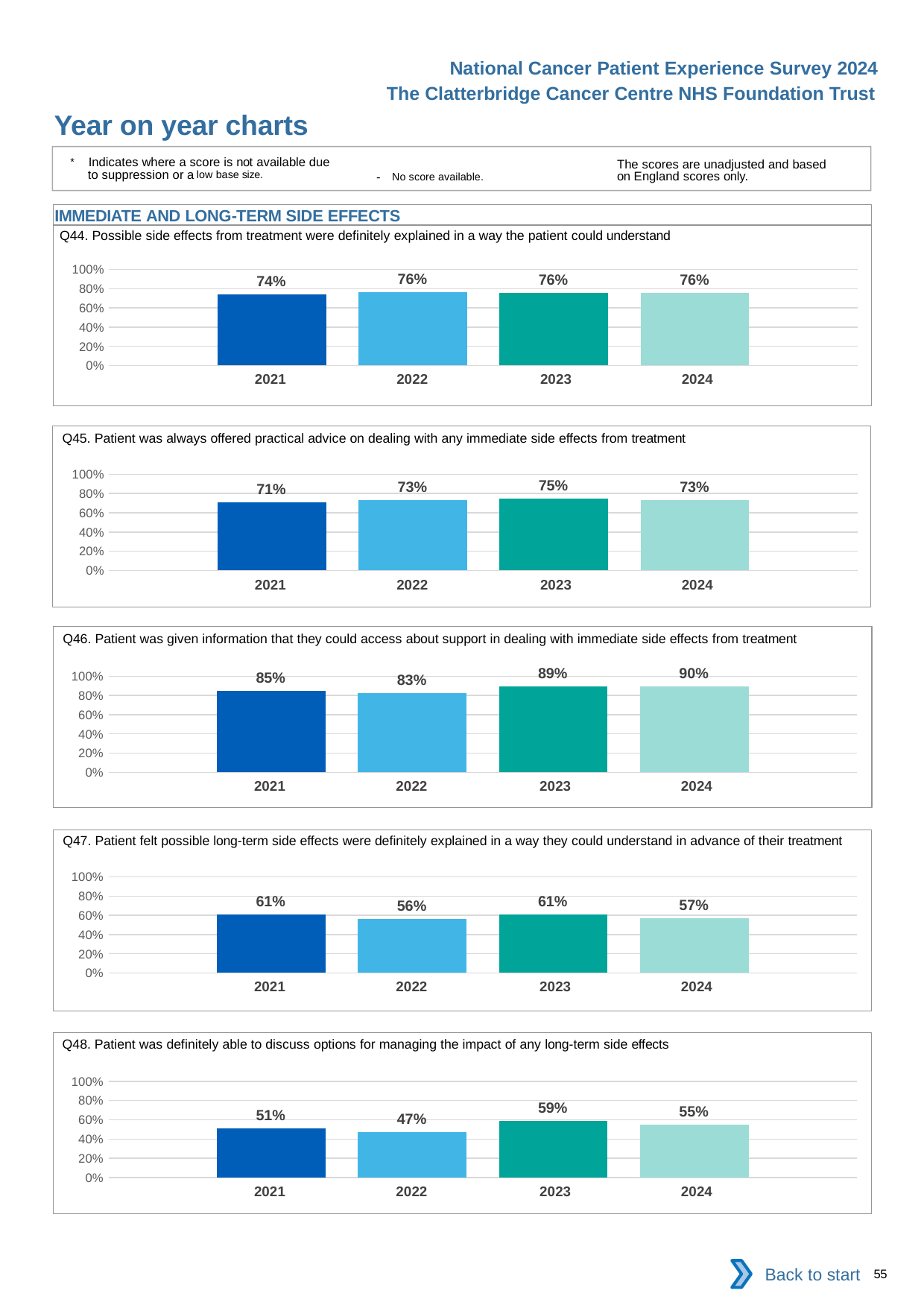
In the Q45 chart, what is the value for 2024? 73% In the Q48 chart, is the value for 2022 greater or less than 60%? less In the Q47 chart, what is the value for 2023? 61% How many years are shown on the x axis of the Q44 chart? 4 What is the section heading printed above the Q44 chart? IMMEDIATE AND LONG-TERM SIDE EFFECTS In the Q46 chart, which year has the lowest value? 2022 In the Q45 chart, which year has the highest value? 2023 What kind of chart is the Q48 chart? bar chart In the Q47 chart, which is larger, the value for 2022 or the value for 2024? 2024 In the Q48 chart, what is the difference between the 2023 and 2022 values? 12% In the Q46 chart, what is the difference between the 2024 and 2021 values? 5% In the Q44 chart, what is the value for 2021? 74%